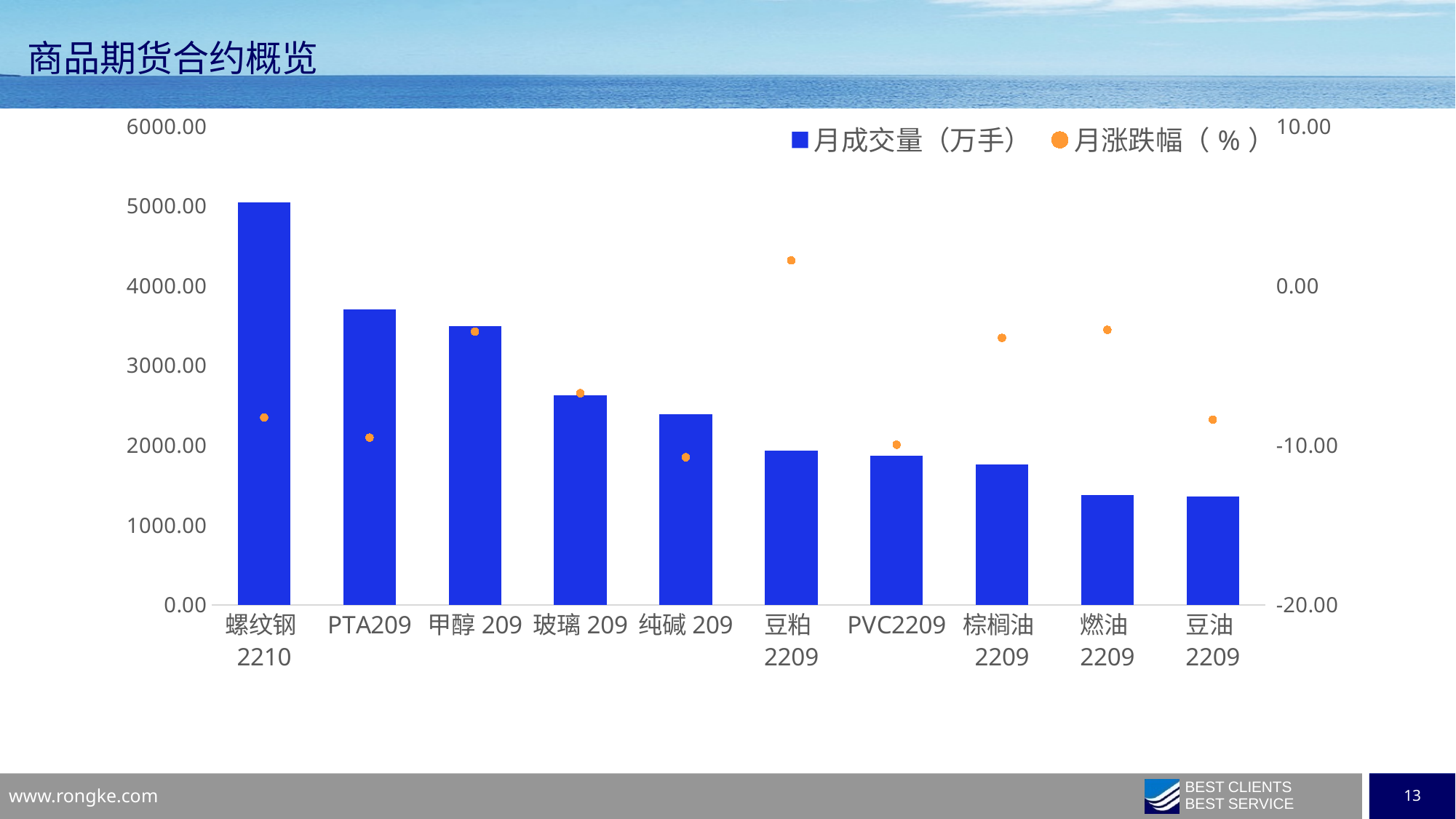
What are the two series named in the legend? 月成交量（万手） and 月涨跌幅（%） Is the 月成交量（万手） for 螺纹钢2210 greater or less than 4000.00? greater Do the 月成交量（万手） bars rise or fall from left to right across the x axis? fall Which contract has the highest 月成交量（万手）? 螺纹钢2210 What kind of chart is shown on the slide? A combination chart of bars and points (bar chart with a dot series) How many contracts (categories) are shown on the x axis? 10 Is the 月成交量（万手） for 玻璃 209 greater or less than 3000.00? less Which has the larger 月成交量（万手）, PTA209 or 甲醇 209? PTA209 Which contract has the highest 月涨跌幅（%）? 豆粕 2209 How many series does the legend list? 2 Is the 月涨跌幅（%） for 甲醇 209 greater or less than -10.00? greater